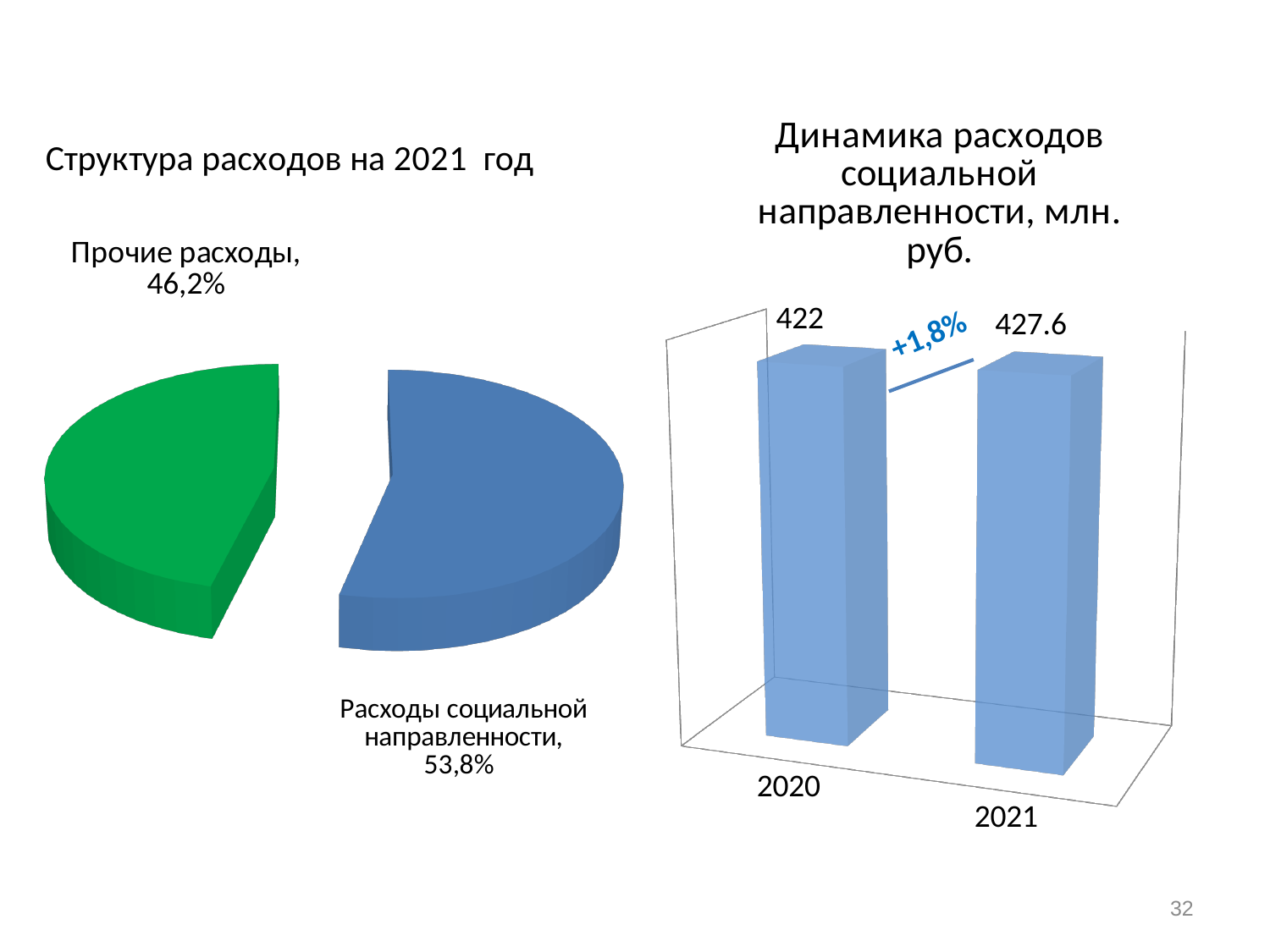
In the chart titled "Динамика расходов социальной направленности, млн. руб.", what percentage change is annotated between 2020 and 2021? +1,8% In the chart titled "Структура расходов на 2021 год", what share does "Расходы социальной направленности" have? 53,8% In the chart titled "Структура расходов на 2021 год", which slice is larger: "Прочие расходы" or "Расходы социальной направленности"? Расходы социальной направленности In the chart titled "Динамика расходов социальной направленности, млн. руб.", by how much does the 2021 value exceed the 2020 value? 5.6 What kind of chart is the one titled "Динамика расходов социальной направленности, млн. руб."? Bar chart In the chart titled "Структура расходов на 2021 год", how many slices does the pie have? 2 In the chart titled "Структура расходов на 2021 год", what share does "Прочие расходы" have? 46,2% In the chart titled "Динамика расходов социальной направленности, млн. руб.", what is the value for 2021? 427.6 In the chart titled "Динамика расходов социальной направленности, млн. руб.", what is the value for 2020? 422 In the chart titled "Динамика расходов социальной направленности, млн. руб.", which year has the higher value? 2021 In the chart titled "Структура расходов на 2021 год", what colour is the "Прочие расходы" slice? Green What kind of chart is the one titled "Структура расходов на 2021 год"? Pie chart